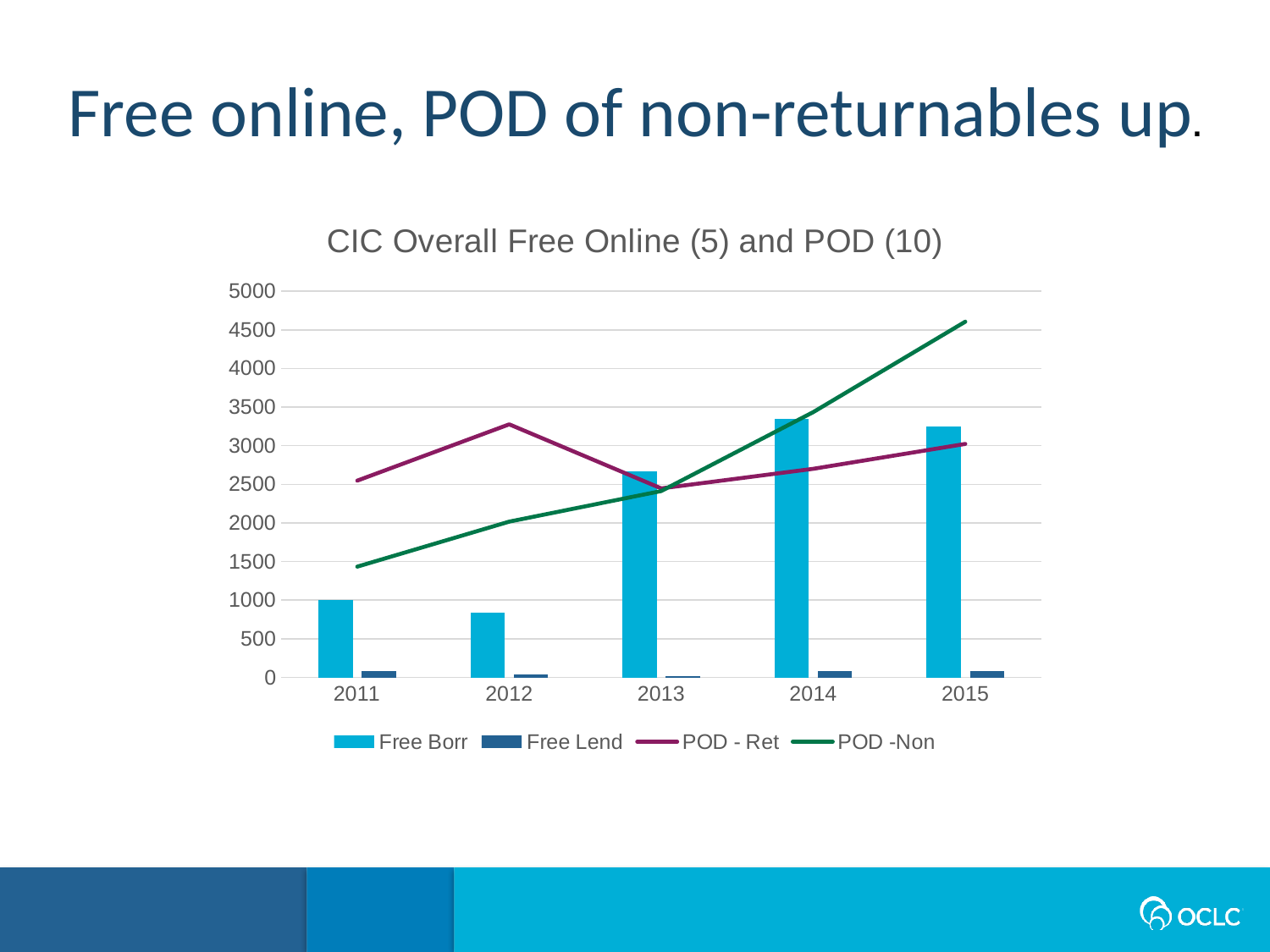
Is the value for Free Borr in 2011 greater or less than 1500? less Does the POD -Non line rise or fall from 2011 to 2015? Rises In which year is the POD - Ret line at its lowest? 2013 In 2011, which is larger: POD - Ret or POD -Non? POD - Ret In which year is the POD - Ret line at its highest? 2012 In which year is the POD -Non line at its highest? 2015 Is the value for POD -Non in 2015 greater or less than 4000? greater What is the title of the chart? CIC Overall Free Online (5) and POD (10) How many years are shown on the x axis? 5 How many series does the legend list? 4 What kind of chart is this? Combined bar and line chart In which year is the Free Borr bar the shortest? 2012